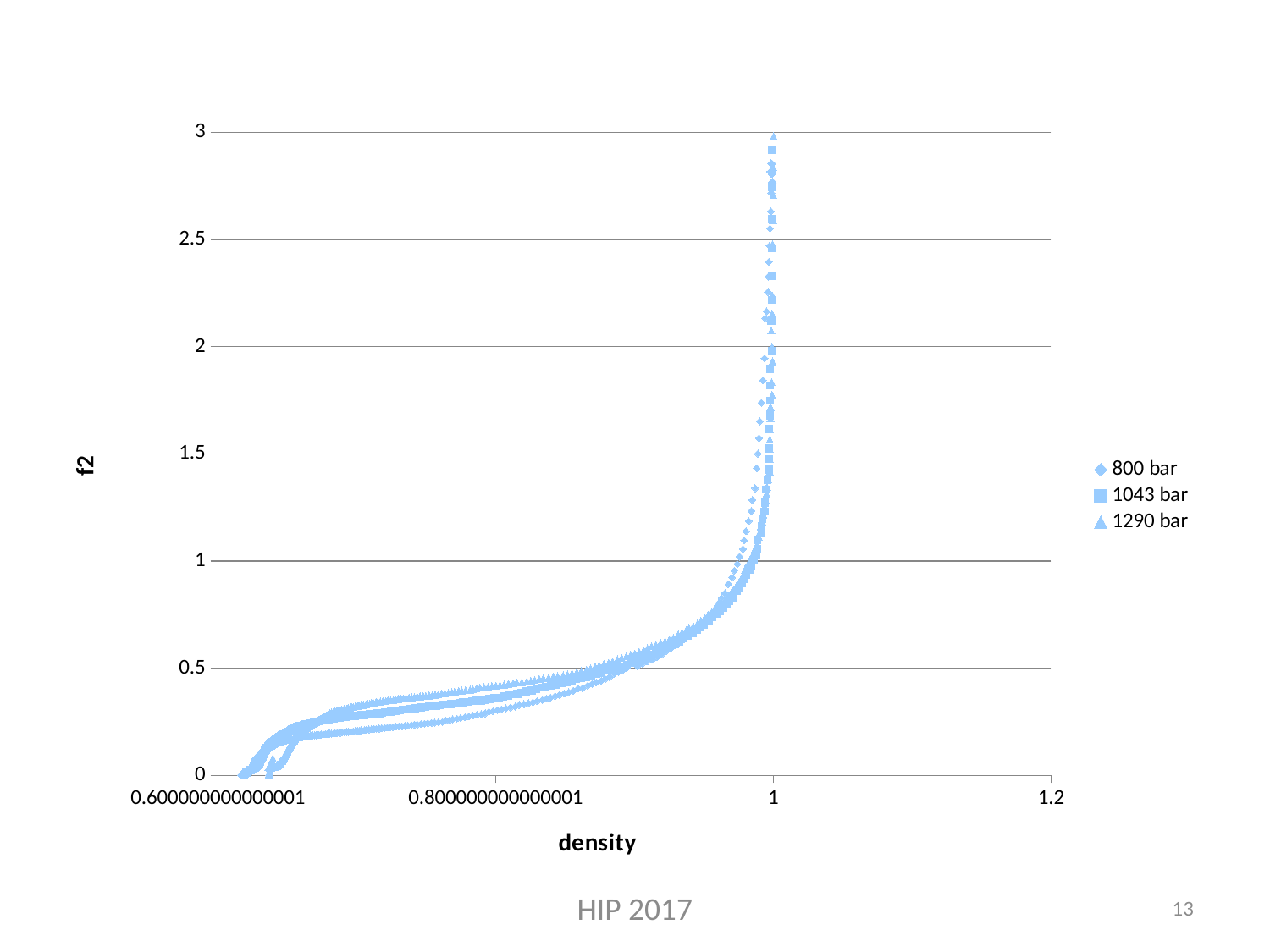
What is the label of the x axis? density Is the f2 value for the 1290 bar series at a density of 0.7 greater or less than 0.5? less Is the highest f2 value reached by the 1290 bar series greater or less than 2.5? greater Is the f2 value for the 800 bar series at a density of 0.8 greater or less than 0.5? less Which series uses triangle markers? 1290 bar What kind of chart is shown on the slide? scatter chart Does f2 rise or fall as density increases along the x axis? rise What are the series names listed in the legend? 800 bar, 1043 bar, 1290 bar How many series does the legend list? 3